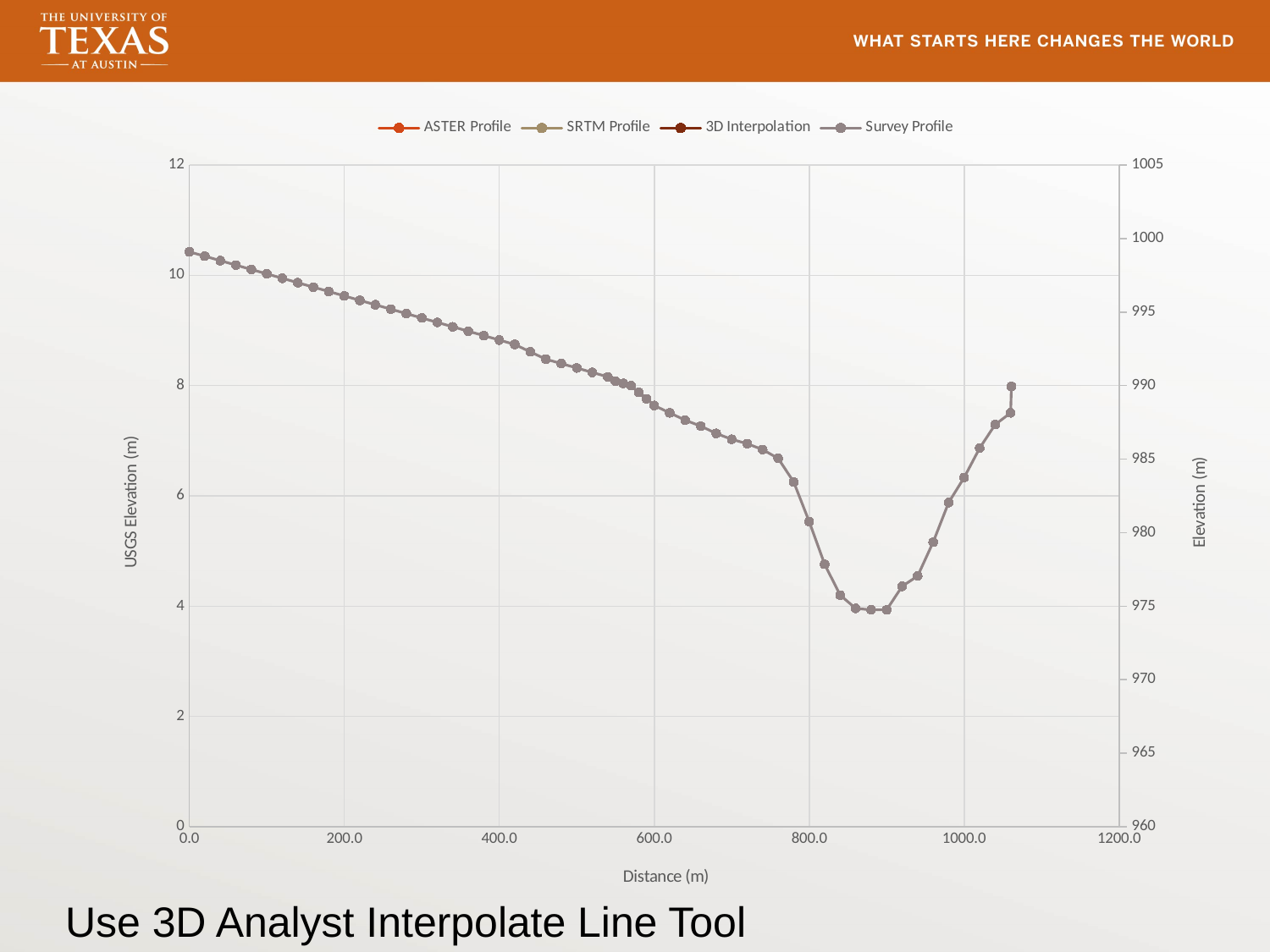
Read against the right-hand Elevation (m) axis, is the lowest point of the plotted line greater or less than 980? less Read against the right-hand Elevation (m) axis, is the value of the plotted line at distance 0.0 greater or less than 995? greater Is the plotted value at distance 200.0 larger or smaller than the plotted value at distance 800.0? larger Between distance 0.0 and 800.0 on the x axis, does the plotted line rise or fall? fall What kind of chart is shown on the slide? line chart What is the highest tick value shown on the right-hand Elevation (m) axis? 1005 Read against the left-hand USGS Elevation (m) axis, is the value of the plotted line at distance 400.0 greater or less than 8? greater How many series does the chart's legend list? 4 Between distance 900.0 and 1060.0 on the x axis, does the plotted line rise or fall? rise Does the lowest point of the plotted line fall between 800.0 and 1000.0 on the x axis? yes What is the title of the x axis? Distance (m) What are the four series named in the legend? ASTER Profile, SRTM Profile, 3D Interpolation, Survey Profile